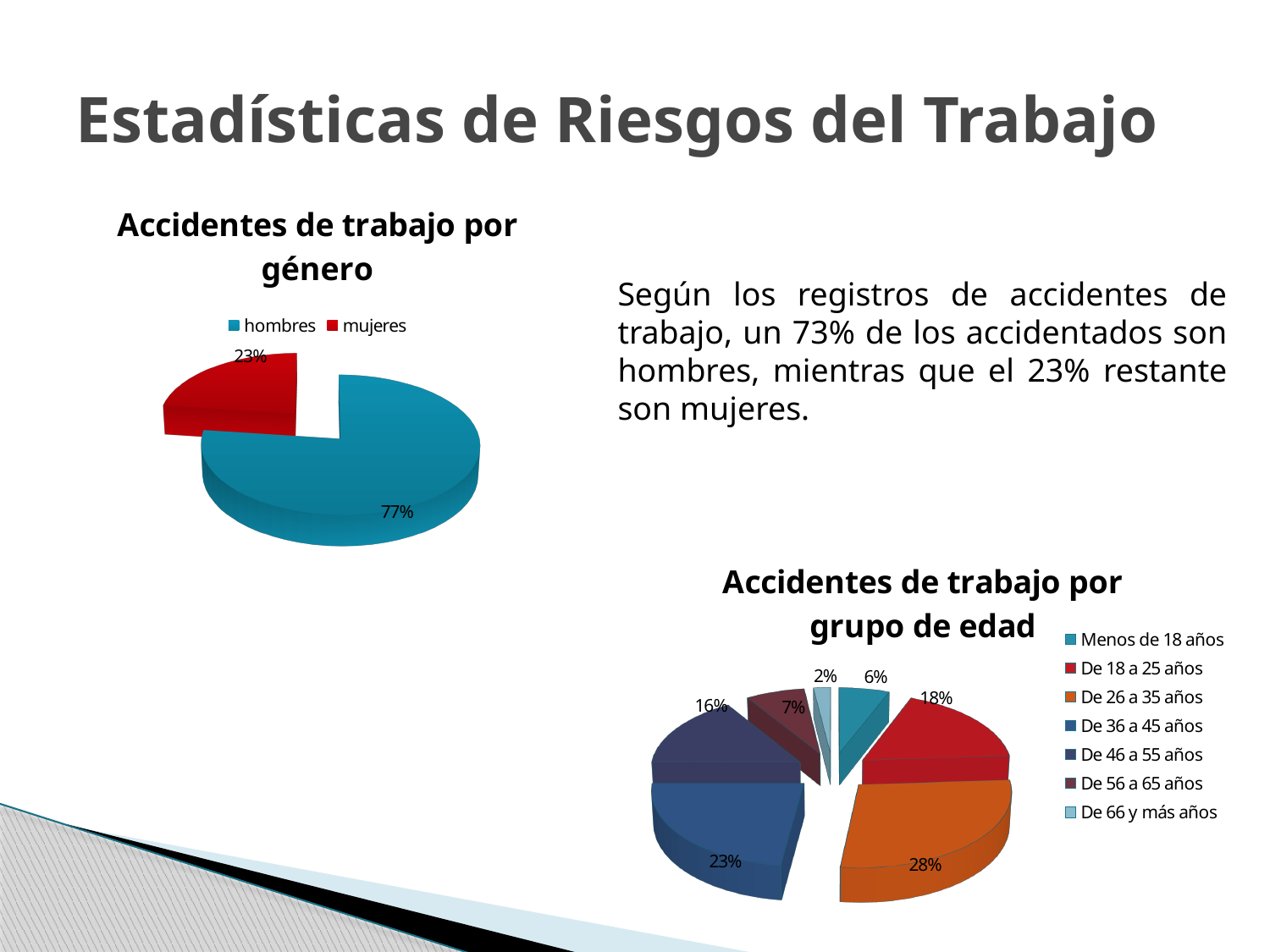
How many series does the legend of the chart 'Accidentes de trabajo por género' list? 2 What kind of chart is 'Accidentes de trabajo por género'? Pie chart In the chart 'Accidentes de trabajo por grupo de edad', what percentage corresponds to 'De 66 y más años'? 2% How many age groups are shown in the chart 'Accidentes de trabajo por grupo de edad'? 7 In the chart 'Accidentes de trabajo por grupo de edad', which age group has the largest share? De 26 a 35 años In the chart 'Accidentes de trabajo por grupo de edad', what is the difference in percentage points between 'De 18 a 25 años' and 'De 56 a 65 años'? 11 In the chart 'Accidentes de trabajo por grupo de edad', which is larger: 'De 36 a 45 años' or 'De 46 a 55 años'? De 36 a 45 años In the chart 'Accidentes de trabajo por grupo de edad', which age group has the smallest share? De 66 y más años In the chart 'Accidentes de trabajo por género', what is the difference in percentage points between hombres and mujeres? 54 In the chart 'Accidentes de trabajo por género', what percentage of accidents corresponds to mujeres? 23% In the chart 'Accidentes de trabajo por grupo de edad', what percentage corresponds to 'De 26 a 35 años'? 28% In the chart 'Accidentes de trabajo por género', what percentage of accidents corresponds to hombres? 77%